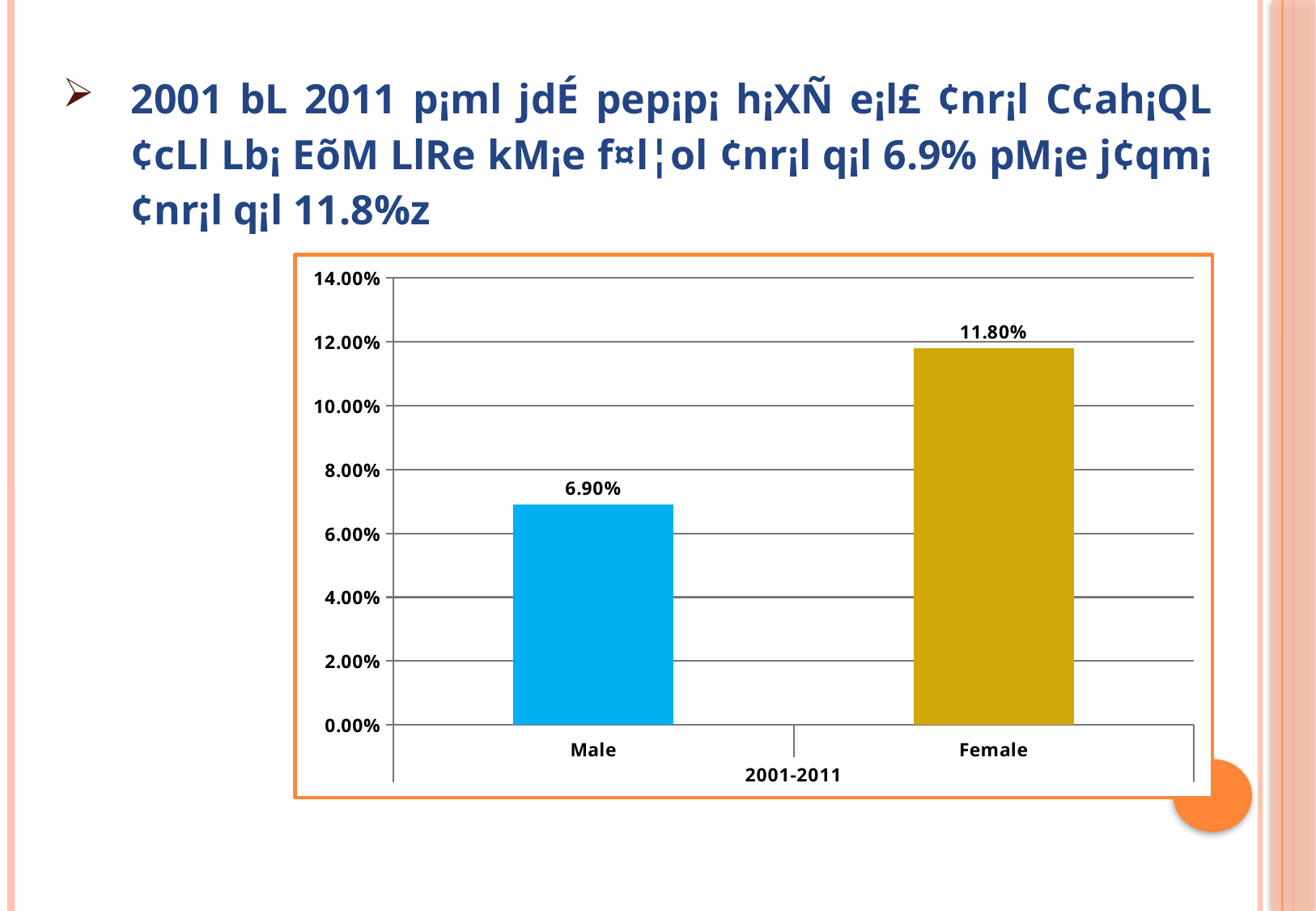
What is the label shown beneath the x axis of the chart? 2001-2011 What kind of chart is shown on the slide? bar chart What is the value for Male in the chart? 6.90% Which is larger, the value for Male or the value for Female? Female Which category has the lowest value in the chart? Male How many categories are shown on the x axis of the chart? 2 What is the value for Female in the chart? 11.80% What is the difference between the Female and Male values? 4.90% Is the value for Female greater or less than 10.00%? greater Is the value for Male greater or less than 8.00%? less What is the highest value shown on the y axis of the chart? 14.00% Which category has the highest value in the chart? Female